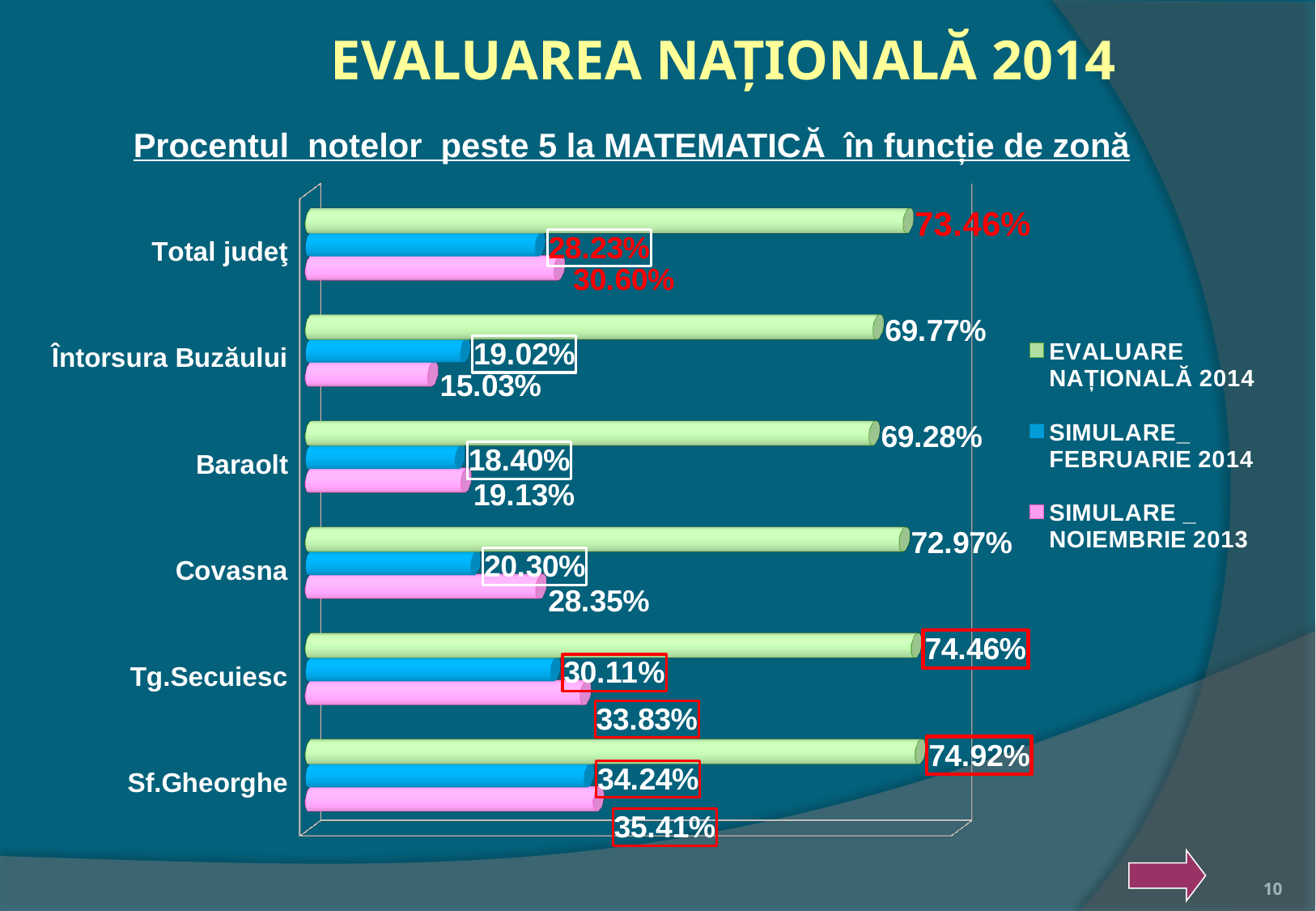
How many categories (zones) are shown on the chart? 6 Which zone has the highest EVALUARE NAȚIONALĂ 2014 value? Sf.Gheorghe What is the SIMULARE_NOIEMBRIE 2013 value for Întorsura Buzăului? 15.03% What is the SIMULARE_FEBRUARIE 2014 value for Covasna? 20.30% What is the EVALUARE NAȚIONALĂ 2014 value for Total judeţ? 73.46% What colour are the bars for the SIMULARE_FEBRUARIE 2014 series? blue Which zone has the lowest SIMULARE_NOIEMBRIE 2013 value? Întorsura Buzăului What is the difference between the EVALUARE NAȚIONALĂ 2014 value and the SIMULARE_FEBRUARIE 2014 value for Sf.Gheorghe? 40.68% What is the difference between the SIMULARE_NOIEMBRIE 2013 values for Tg.Secuiesc and Covasna? 5.48% What type of chart is shown on the slide? bar chart How many series does the legend list? 3 For Baraolt, which is larger: the SIMULARE_FEBRUARIE 2014 value or the SIMULARE_NOIEMBRIE 2013 value? SIMULARE_NOIEMBRIE 2013